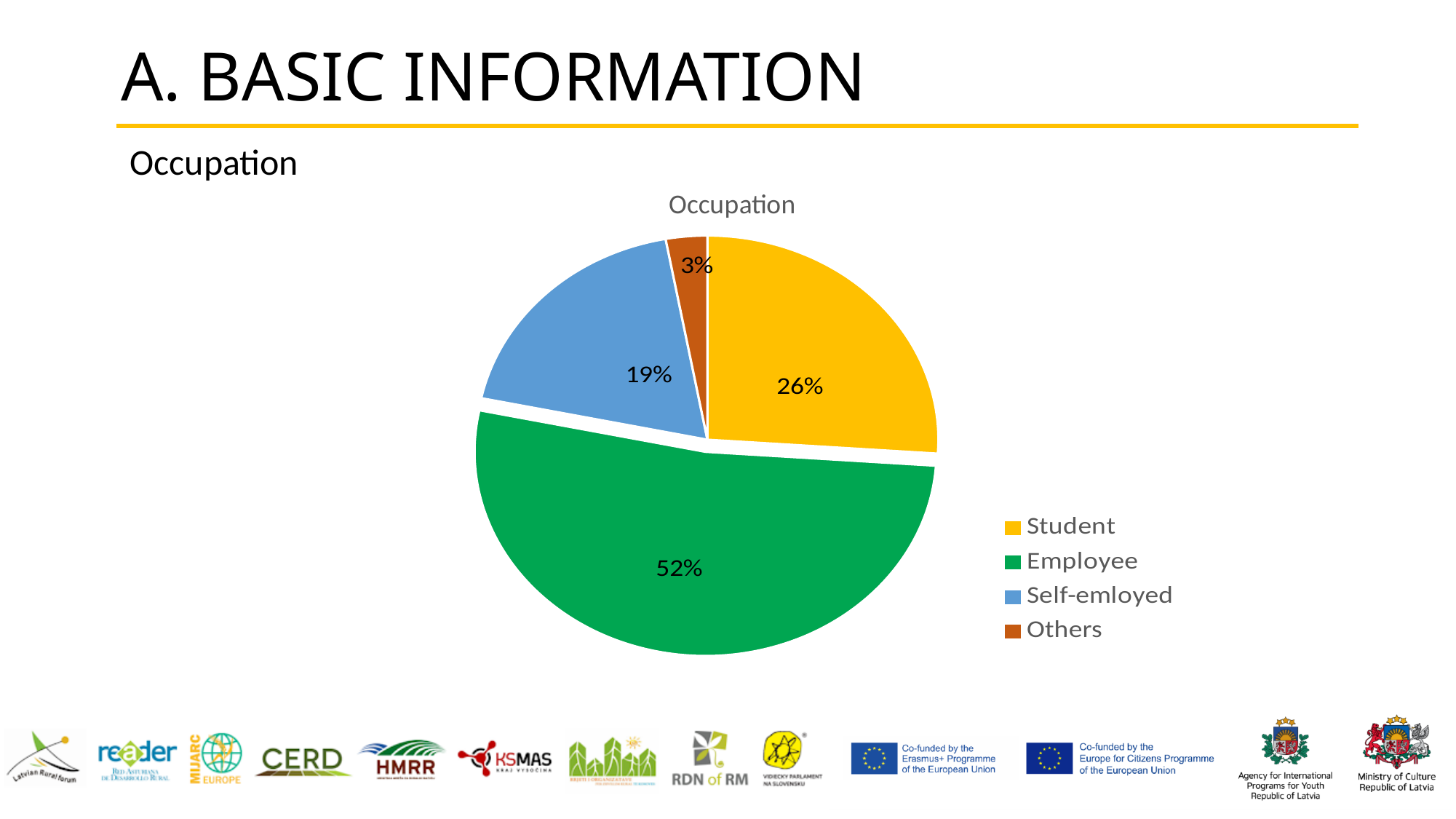
What colour is the Employee slice? Green What share of the pie is Student? 26% Which category has the smallest share of the pie? Others What is the title of the chart? Occupation What is the difference in percentage points between Employee and Student? 26 What share of the pie is Employee? 52% How many categories does the legend list? 4 What share of the pie is Others? 3% Which is larger, the share for Student or the share for Self-emloyed? Student What type of chart is shown on the slide? Pie chart Which category has the largest share of the pie? Employee